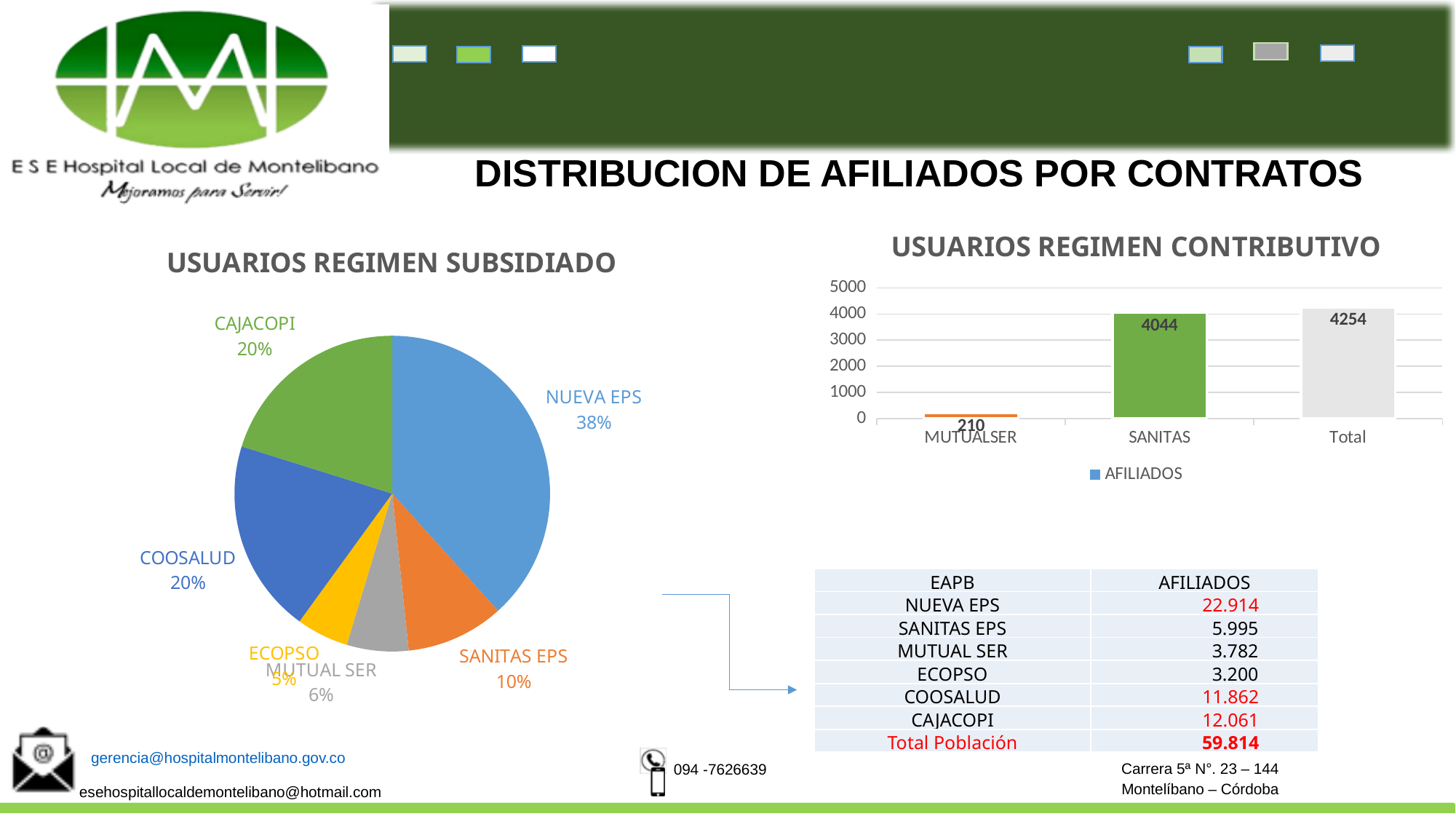
In the USUARIOS REGIMEN CONTRIBUTIVO chart, what series name does the legend show? AFILIADOS In the USUARIOS REGIMEN SUBSIDIADO chart, what share of the pie does NUEVA EPS have? 38% In the USUARIOS REGIMEN CONTRIBUTIVO chart, what is the value for MUTUALSER? 210 In the USUARIOS REGIMEN CONTRIBUTIVO chart, what is the value for SANITAS? 4044 In the USUARIOS REGIMEN SUBSIDIADO chart, how many slices does the pie have? 6 What kind of chart is USUARIOS REGIMEN SUBSIDIADO? Pie chart What kind of chart is USUARIOS REGIMEN CONTRIBUTIVO? Bar chart In the USUARIOS REGIMEN SUBSIDIADO chart, what is the difference in percentage points between NUEVA EPS and CAJACOPI? 18 In the USUARIOS REGIMEN CONTRIBUTIVO chart, what is the difference between Total and SANITAS? 210 In the USUARIOS REGIMEN SUBSIDIADO chart, which category has the largest slice? NUEVA EPS In the USUARIOS REGIMEN SUBSIDIADO chart, what percentage is shown for SANITAS EPS? 10% In the USUARIOS REGIMEN SUBSIDIADO chart, which category has the smallest slice? ECOPSO